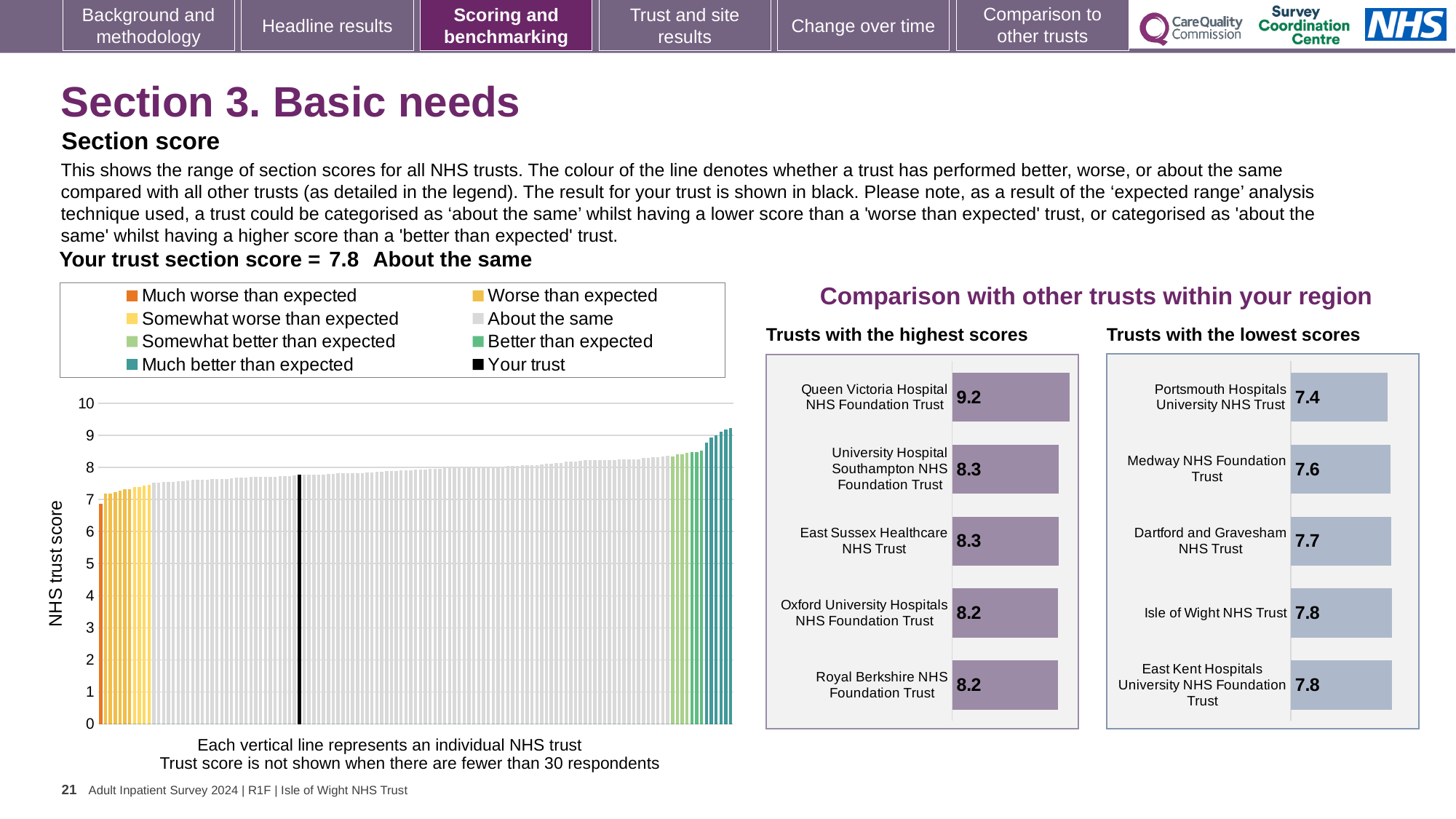
How many entries does the legend of the main section score chart on the left list? 8 In the 'Trusts with the highest scores' chart, what is the score for Queen Victoria Hospital NHS Foundation Trust? 9.2 How many trusts are shown in the 'Trusts with the highest scores' chart? 5 What is the y-axis label of the main section score chart on the left? NHS trust score In the 'Trusts with the lowest scores' chart, what is the difference between the scores of Isle of Wight NHS Trust and Portsmouth Hospitals University NHS Trust? 0.4 What kind of chart is the main section score chart on the left of the slide? Bar chart In the 'Trusts with the lowest scores' chart, which trust has the lowest score? Portsmouth Hospitals University NHS Trust In the 'Trusts with the highest scores' chart, what is the difference between the scores of Queen Victoria Hospital NHS Foundation Trust and East Sussex Healthcare NHS Trust? 0.9 In the 'Trusts with the lowest scores' chart, what is the score for Medway NHS Foundation Trust? 7.6 In the main section score chart on the left, do the trust scores rise or fall from left to right? Rise In the 'Trusts with the highest scores' chart, which trust has the highest score? Queen Victoria Hospital NHS Foundation Trust In the 'Trusts with the lowest scores' chart, which has the higher score: Medway NHS Foundation Trust or Dartford and Gravesham NHS Trust? Dartford and Gravesham NHS Trust